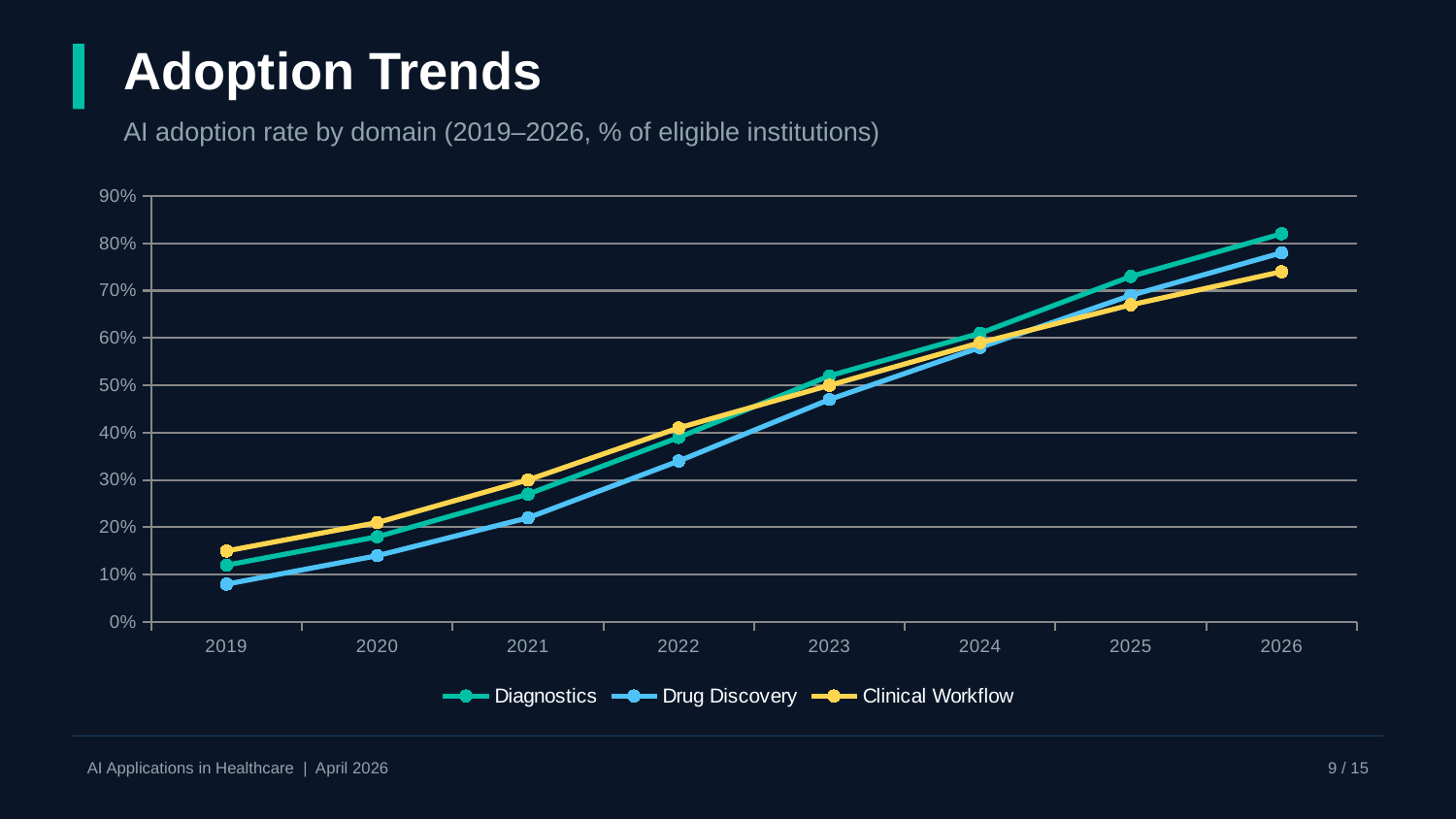
Is the value for Clinical Workflow in 2026 greater or less than 70%? greater How many series does the legend list? 3 How many years are plotted along the x axis? 8 What is the adoption rate for Clinical Workflow in 2021? 30% Which domain has the lowest adoption rate in 2019? Drug Discovery Do the adoption rates rise or fall from 2019 to 2026? rise Is the value for Drug Discovery in 2019 greater or less than 10%? less What kind of chart is shown on the slide? line chart Which domain has the highest adoption rate in 2026? Diagnostics In 2021, which is larger: Clinical Workflow or Drug Discovery? Clinical Workflow What are the three series named in the legend? Diagnostics, Drug Discovery, Clinical Workflow Is the value for Diagnostics in 2026 greater or less than 80%? greater